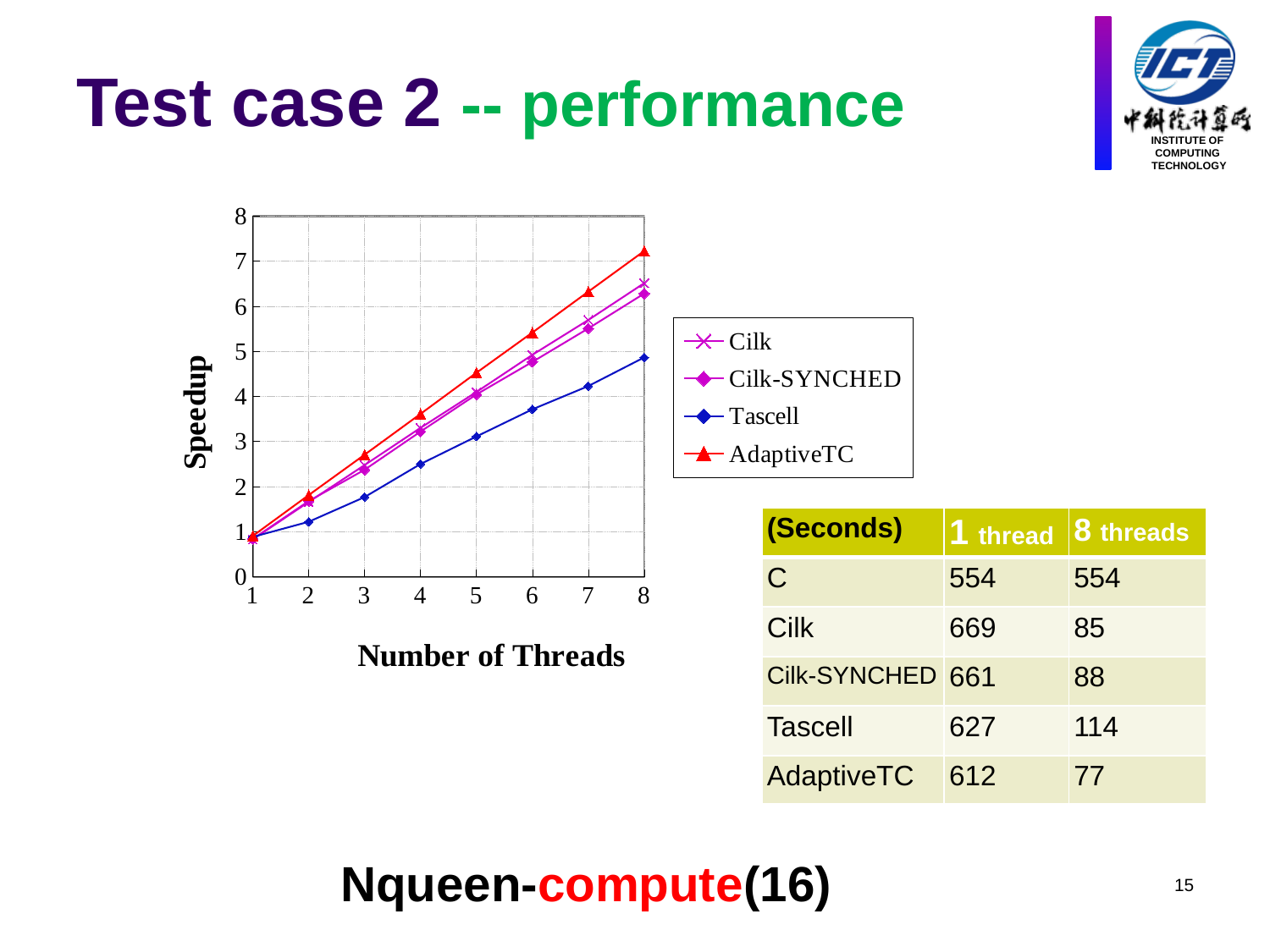
Is the speedup for AdaptiveTC at 8 threads greater or less than 7? greater What kind of chart is shown on the slide? line chart How many thread counts are plotted along the x axis of the chart? 8 Is the speedup for Tascell at 4 threads greater or less than 3? less Is the speedup for Tascell at 8 threads greater or less than 5? less Does the speedup of AdaptiveTC rise or fall as the number of threads increases? rise What is the title of the chart's vertical axis? Speedup Which series has the lowest speedup at 8 threads? Tascell At 6 threads, which has the larger speedup, Tascell or AdaptiveTC? AdaptiveTC Which series has the highest speedup at 8 threads? AdaptiveTC How many series does the chart's legend list? 4